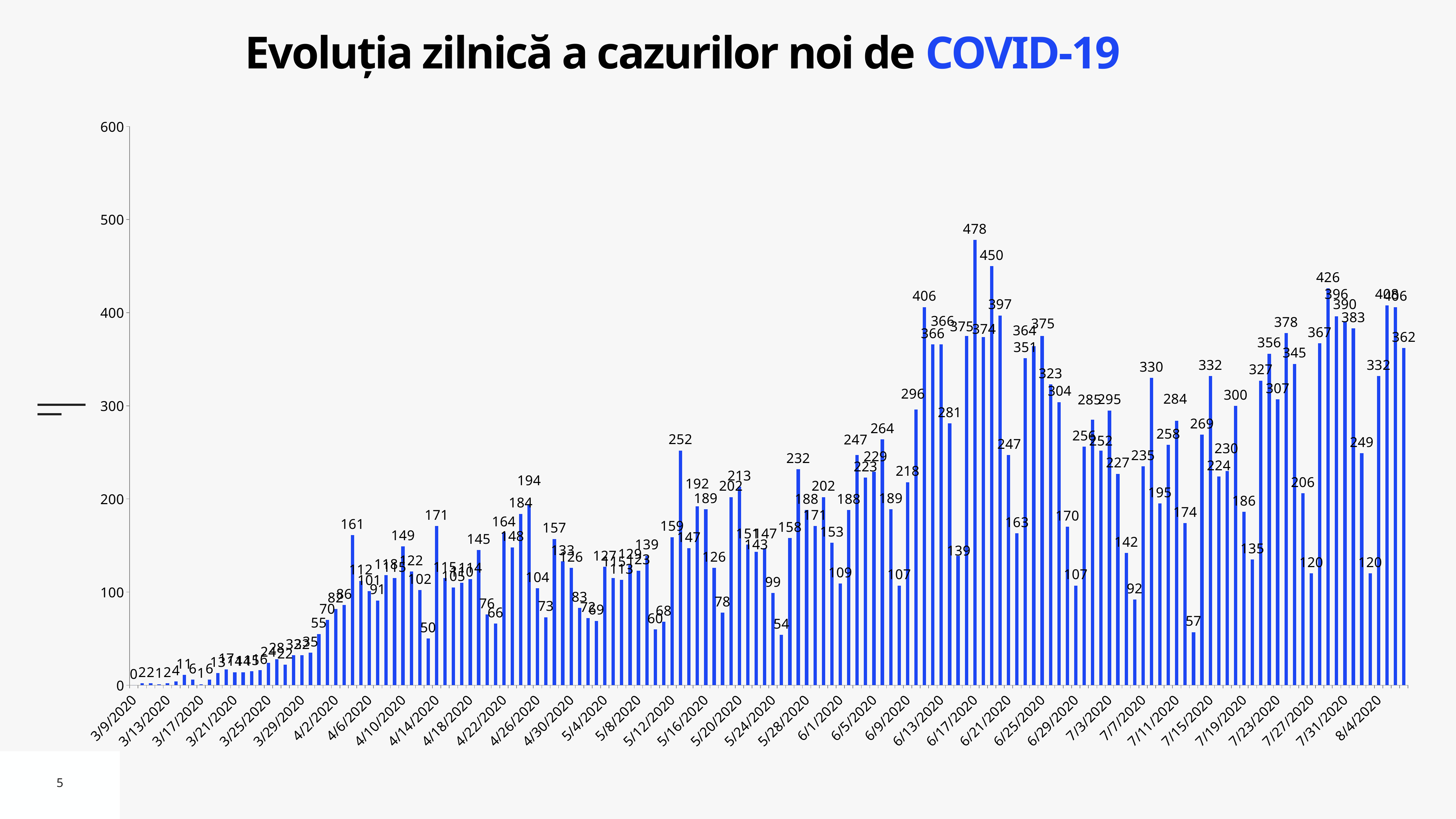
What is the title of the chart? Evoluția zilnică a cazurilor noi de COVID-19 What kind of chart is shown on the slide? bar chart What is the value for 3/9/2020, the first date on the x axis? 0 What is the lowest daily value shown in the chart? 0 What is the highest daily value shown in the chart? 478 Is the highest bar in the chart greater or less than 400? greater Which is larger, the peak of 478 in June or the peak of 426 in late July? 478 What is the difference between the two highest values, 478 and 450? 28 What is the second highest daily value labelled in the chart? 450 What is the maximum value shown on the y axis? 600 Do the daily values generally rise or fall from March to August along the x axis? rise